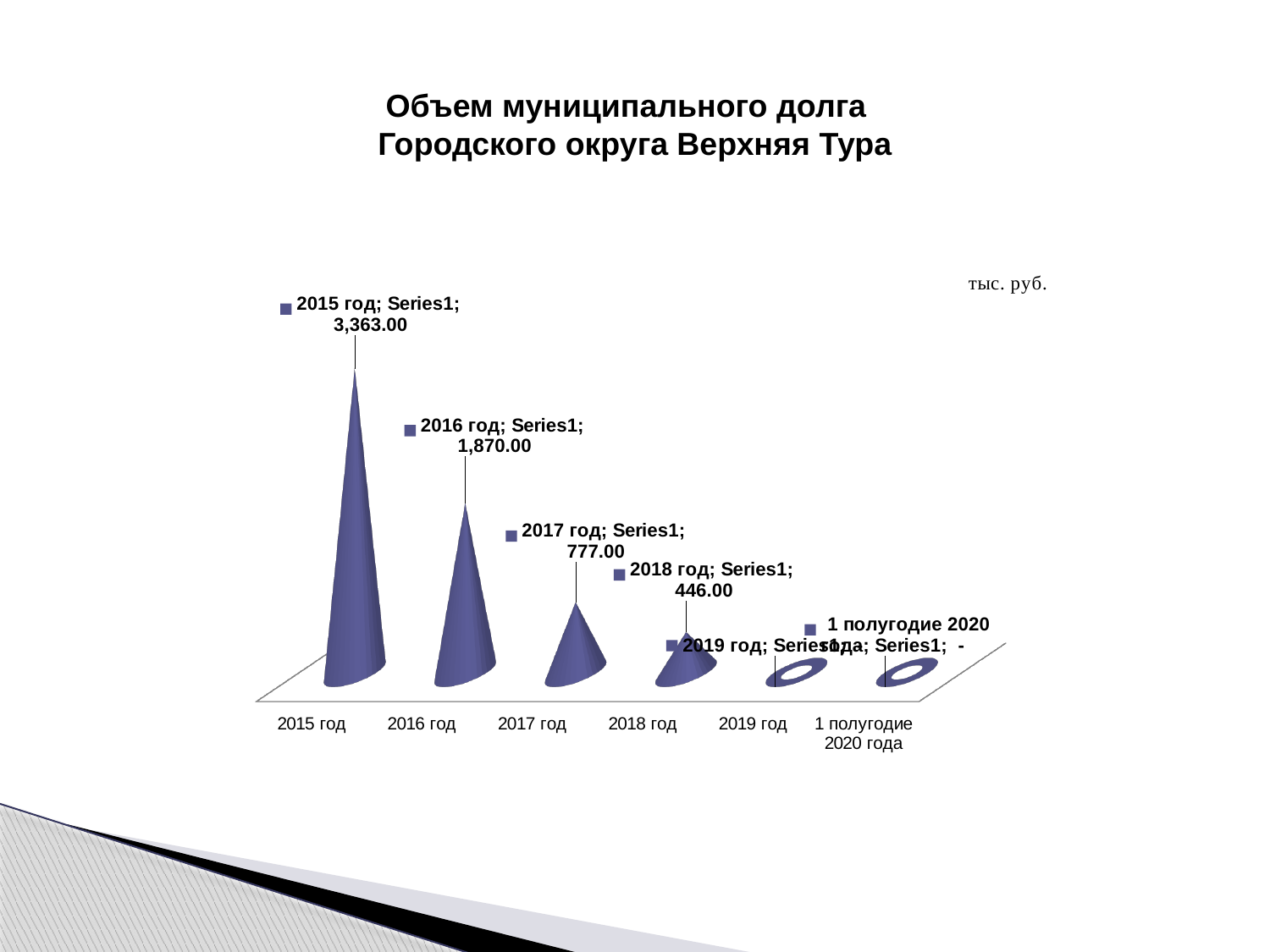
Which category has the highest value? 2015 год What is the value for 2018 год? 446.00 Which is larger, the value for 2016 год or the value for 2017 год? 2016 год Do the values rise or fall from 2015 год to 2018 год? Fall What is the difference between the values for 2015 год and 2016 год? 1,493.00 How many categories are shown on the x axis? 6 What is the difference between the values for 2017 год and 2018 год? 331.00 What is the value for 2015 год? 3,363.00 What unit is indicated for the values in the chart? тыс. руб. What is the value for 2016 год? 1,870.00 What is the value for 2017 год? 777.00 What kind of chart is shown on the slide? Bar chart